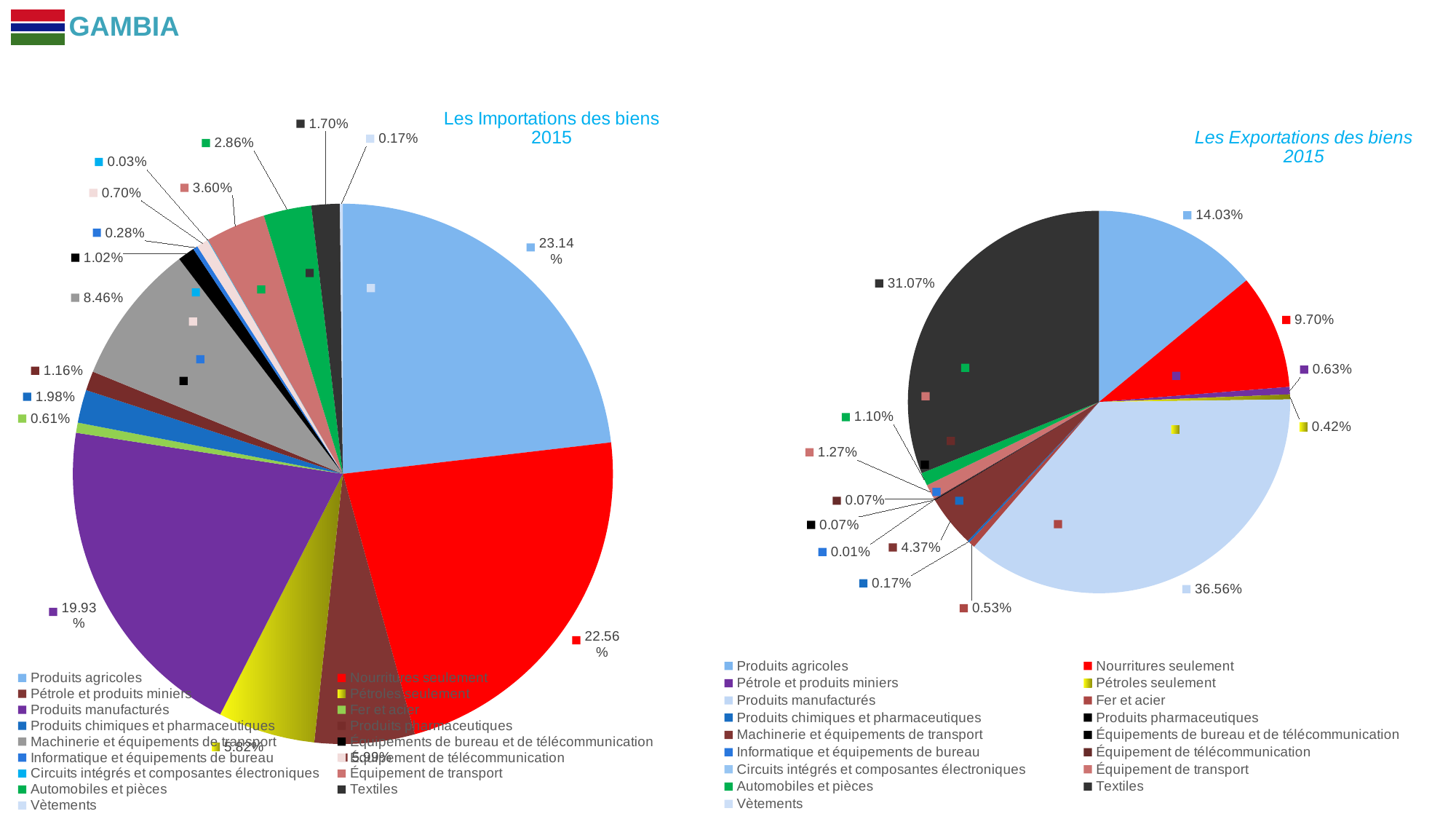
In 'Les Importations des biens 2015', what is the share of Produits manufacturés? 19.93% In 'Les Importations des biens 2015', what is the share of Nourritures seulement? 22.56% In 'Les Exportations des biens 2015', what is the share of Textiles? 31.07% In 'Les Exportations des biens 2015', what is the difference between the shares of Produits manufacturés and Textiles? 5.49% In 'Les Importations des biens 2015', what is the difference between the shares of Produits agricoles and Nourritures seulement? 0.58% In 'Les Exportations des biens 2015', which category has the largest share? Produits manufacturés How many categories does the legend of 'Les Exportations des biens 2015' list? 17 Which is larger: the share of Produits agricoles in 'Les Importations des biens 2015' or in 'Les Exportations des biens 2015'? Les Importations des biens 2015 What kind of chart is used for 'Les Importations des biens 2015'? Pie chart